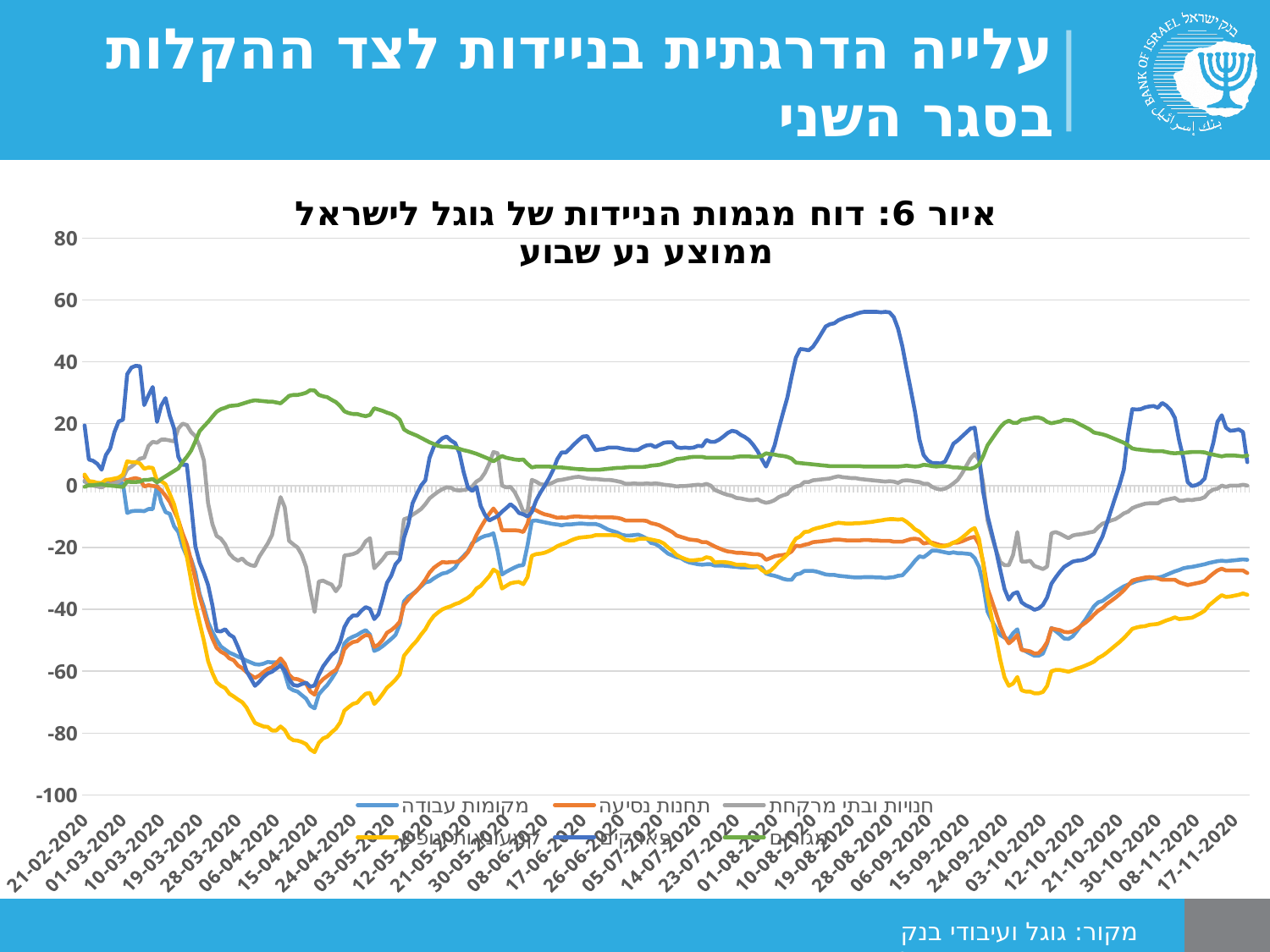
What is the last date label on the x axis? 17-11-2020 How many series does the legend of the chart list? 6 Is the value of the מקומות עבודה series at 17-11-2020 greater or less than 0? less Is the value of the תחנות נסיעה series around 03-10-2020 greater or less than -40? less What is the first date label on the x axis? 21-02-2020 What is the title of the chart? איור 6: דוח מגמות הניידות של גוגל לישראל ממוצע נע שבוע Which series in the legend is drawn in green? מגורים Is the value of the פארקים series around 28-08-2020 greater or less than 40? greater What kind of chart is shown on the slide? line chart